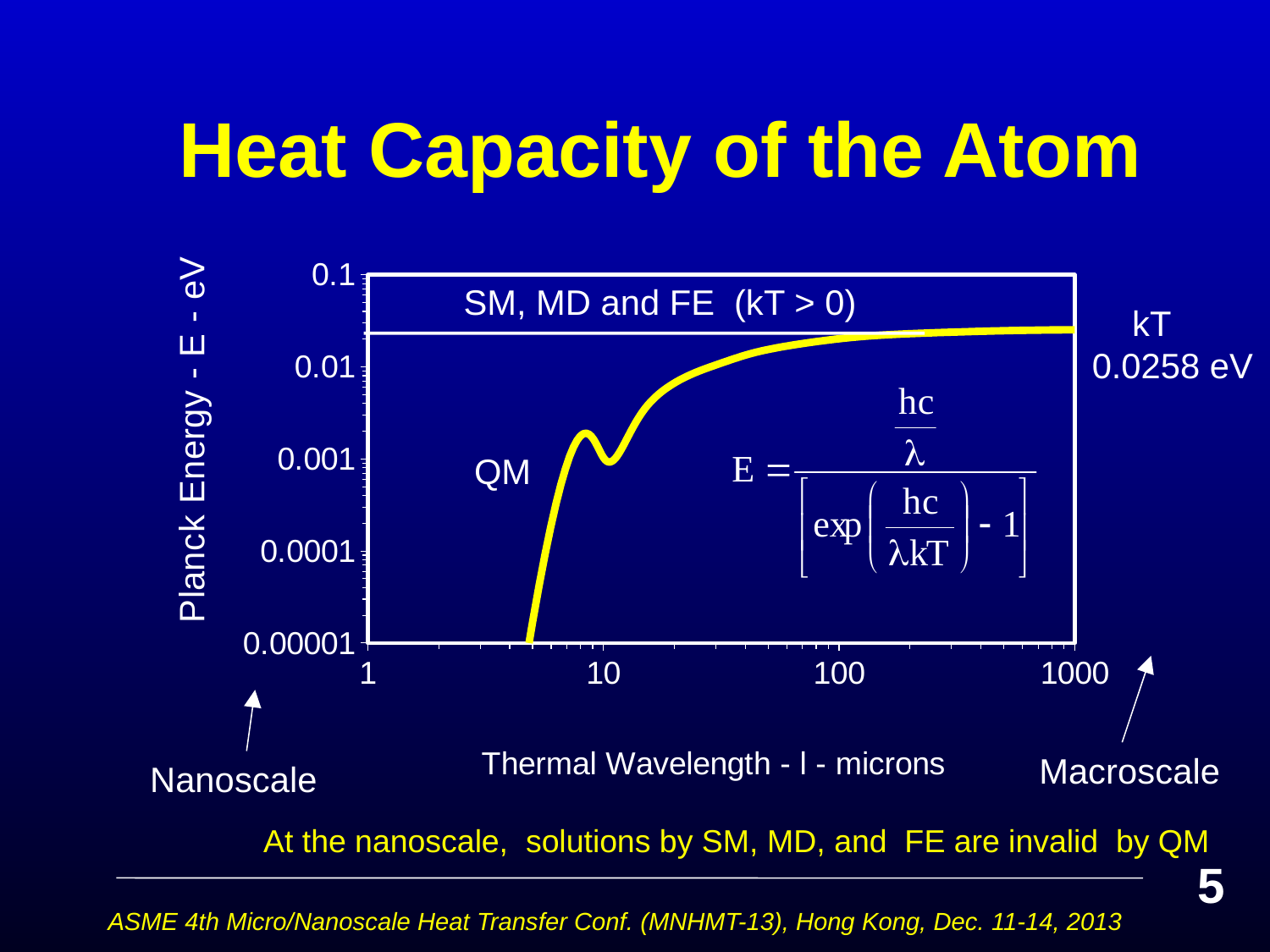
Is the value of the yellow curve at a thermal wavelength of 1000 microns greater or less than 0.01? greater Is the value of the yellow curve at a thermal wavelength of 5 microns greater or less than 0.001? less Is the value of the yellow curve larger at 1000 microns or at 5 microns? 1000 microns Is the value of the yellow curve at a thermal wavelength of 100 microns greater or less than 0.01? greater What is the highest tick value shown on the y axis of the chart? 0.1 What is the largest tick value shown on the x axis of the chart? 1000 What is the label of the y axis of the chart? Planck Energy - E - eV What kind of chart is shown on the slide? line chart Does the yellow curve generally rise or fall as the thermal wavelength increases from 10 to 1000 microns? rise What is the title of the slide containing the chart? Heat Capacity of the Atom What value of kT is annotated to the right of the chart? 0.0258 eV